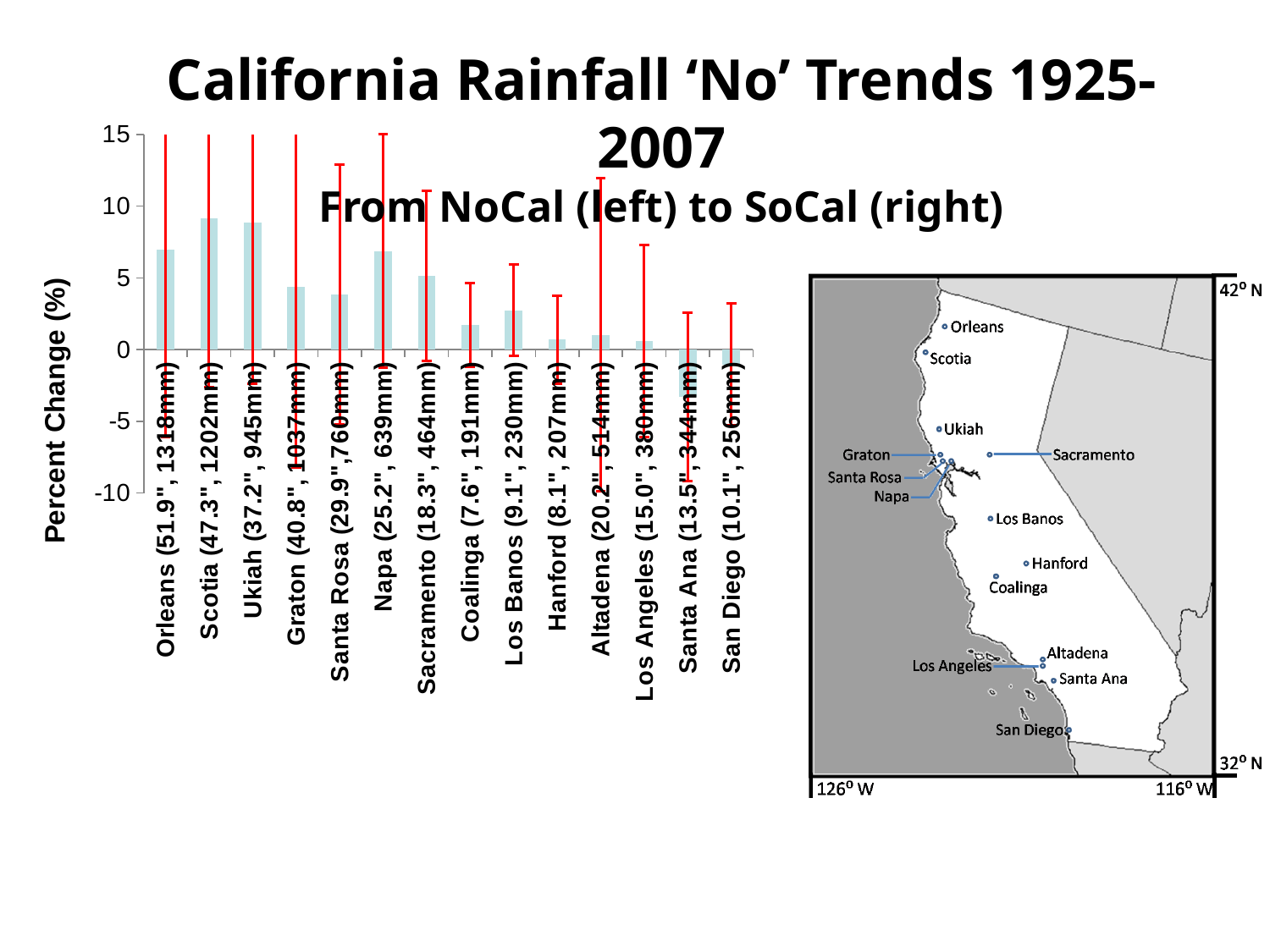
How many cities (categories) are plotted on the bar chart? 14 What is the title of the slide's chart? California Rainfall 'No' Trends 1925-2007 Is the value for Orleans (51.9", 1318mm) greater or less than 5? greater Which has the larger percent change, Napa or Los Banos? Napa Is the value for Coalinga (7.6", 191mm) greater or less than 5? less What is the label of the vertical axis of the bar chart? Percent Change (%) Is the value for Scotia (47.3", 1202mm) greater or less than 5? greater Which has the larger percent change, Scotia or Coalinga? Scotia Do the bar values generally rise or fall moving from left (NoCal) to right (SoCal) along the x axis? fall What kind of chart is shown on the slide? Bar chart Which has the larger percent change, Orleans or Graton? Orleans